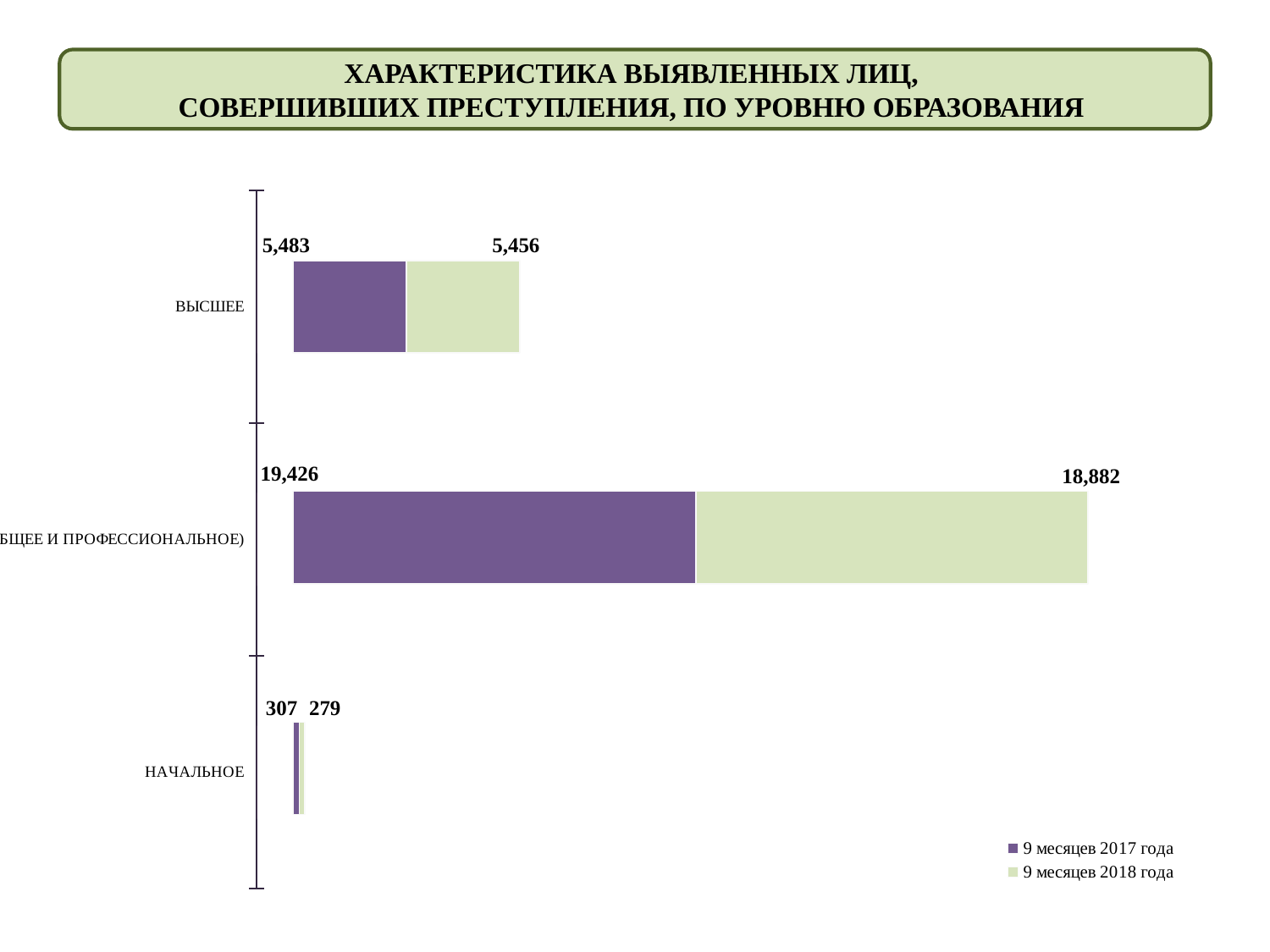
What is the largest value shown for 9 месяцев 2017 года? 19,426 What is the total of the two series for ВЫСШЕЕ? 10,939 What is the value for НАЧАЛЬНОЕ for 9 месяцев 2017 года? 307 What is the smallest value shown for 9 месяцев 2018 года? 279 What is the value for НАЧАЛЬНОЕ for 9 месяцев 2018 года? 279 What kind of chart is shown on the slide? bar chart What is the value for ВЫСШЕЕ for 9 месяцев 2017 года? 5,483 What is the value for ВЫСШЕЕ for 9 месяцев 2018 года? 5,456 How many categories are shown on the chart? 3 How many series does the legend list? 2 What is the difference between the 9 месяцев 2017 года and 9 месяцев 2018 года values for НАЧАЛЬНОЕ? 28 What is the difference between the 9 месяцев 2017 года and 9 месяцев 2018 года values for ВЫСШЕЕ? 27